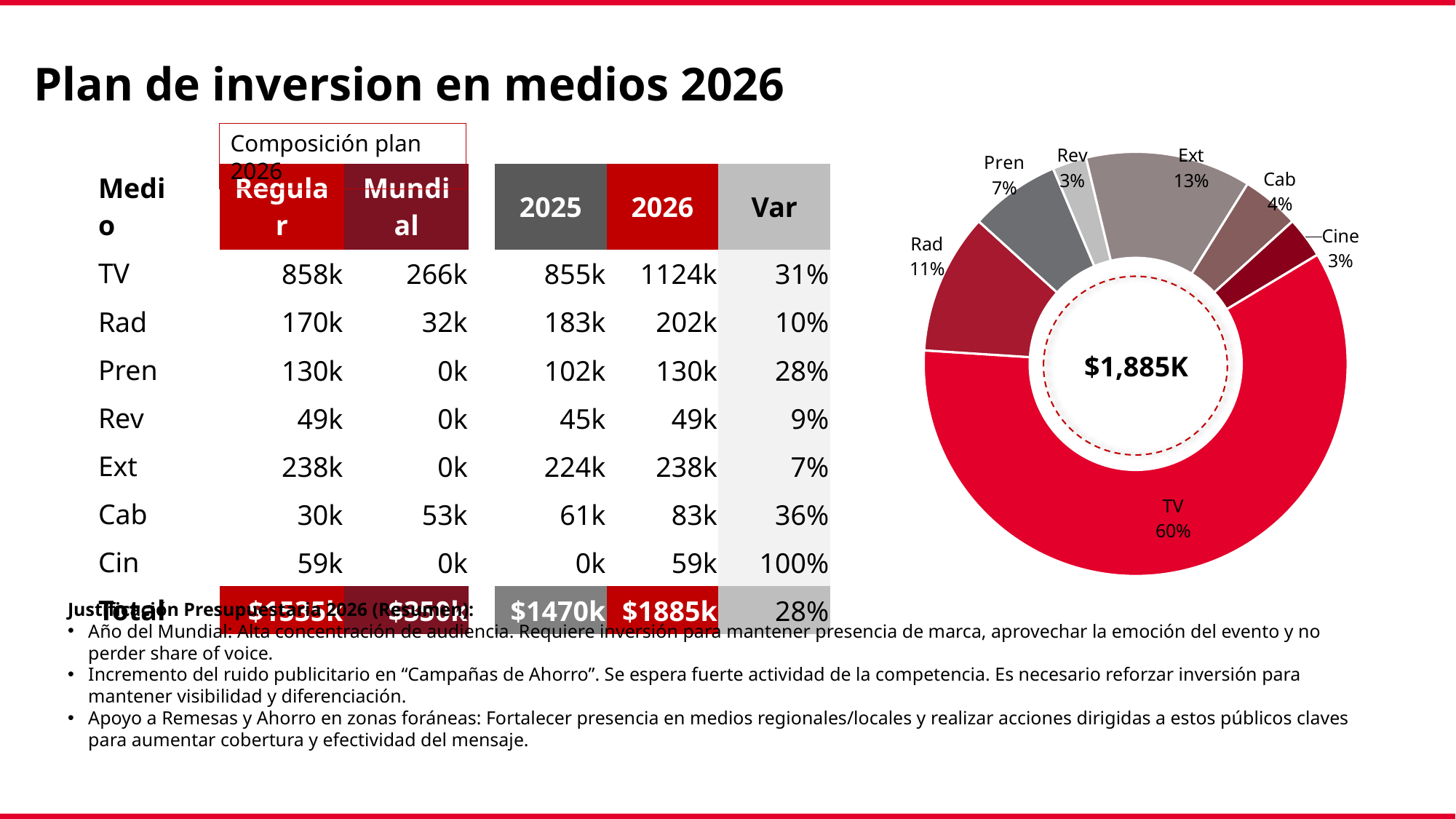
What kind of chart is shown on the right of the slide? Donut (pie) chart What total value is printed in the centre of the donut chart? $1,885K In the donut chart, which slice is larger, Ext or Cab? Ext What share of the donut chart does Rad account for? 11% What share of the donut chart does TV account for? 60% What share of the donut chart does Pren account for? 7% How many slices does the donut chart have? 7 In the donut chart, which slice is larger, Rad or Pren? Rad Which category has the largest slice in the donut chart? TV What is the difference in percentage points between the TV slice and the Ext slice in the donut chart? 47